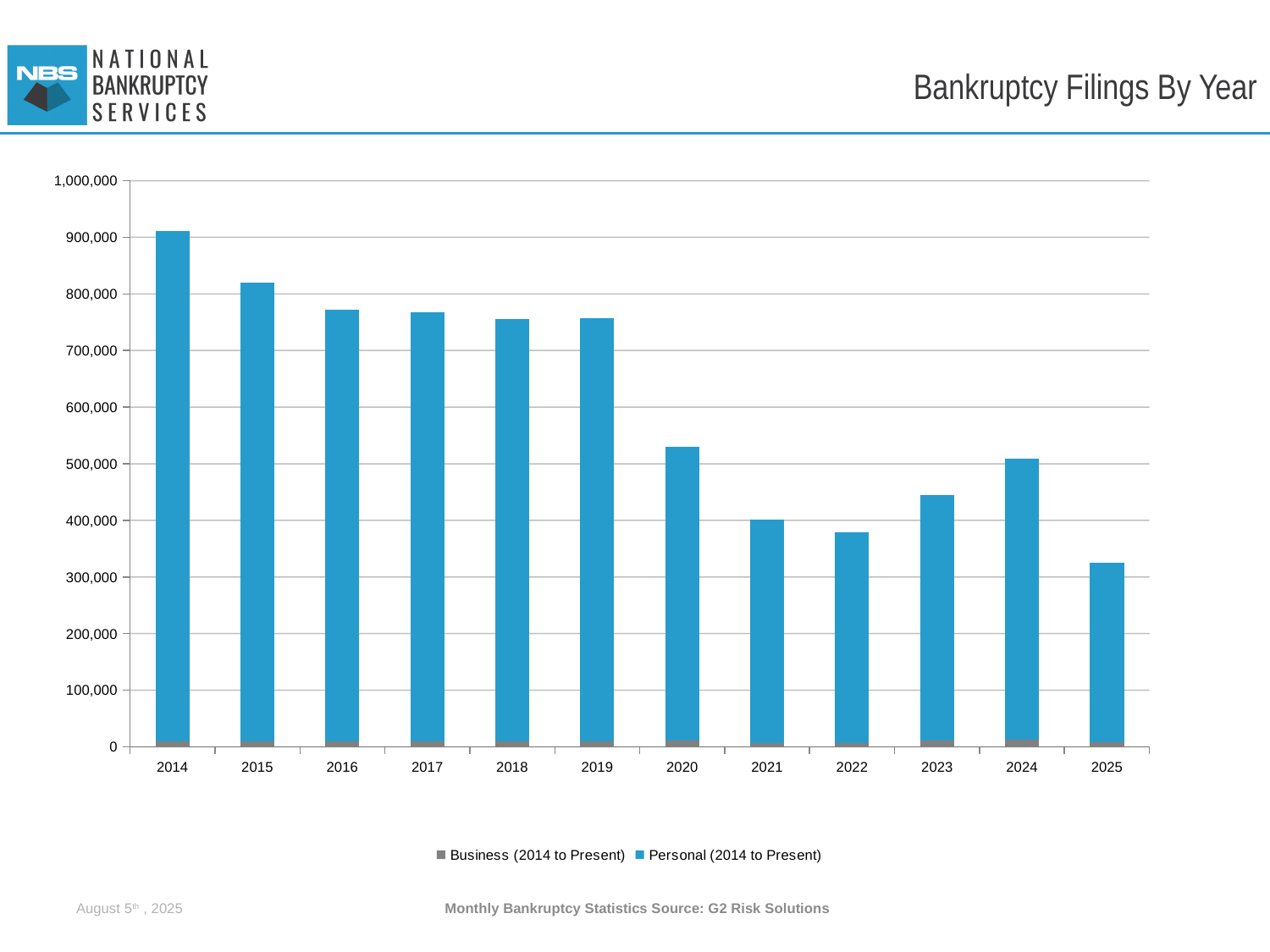
Which year has the lowest total bankruptcy filings? 2025 How many years are shown on the x axis? 12 Is the total value for 2025 greater or less than 400,000? less Which year has the larger total, 2022 or 2023? 2023 What type of chart is shown on the slide? Bar chart What is the title of the chart? Bankruptcy Filings By Year Which year has the highest total bankruptcy filings? 2014 Which year has the larger total, 2020 or 2021? 2020 Is the total value for 2014 greater or less than 800,000? greater Do the total filings rise or fall from 2014 to 2019? fall How many series does the legend list? 2 Is the total value for 2021 greater or less than 500,000? less